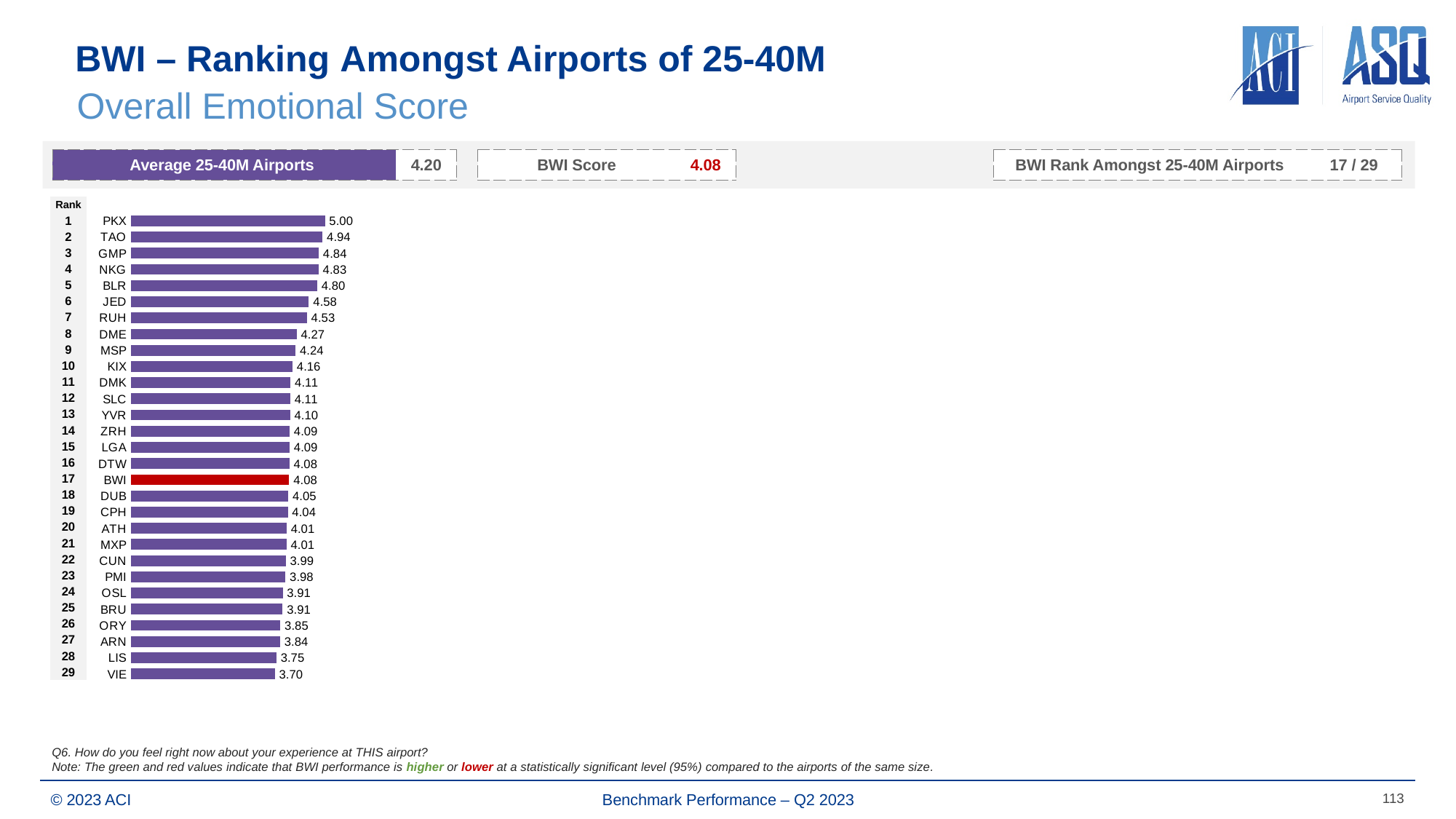
Which airport has the highest Overall Emotional Score? PKX What is the difference between the scores of PKX and VIE? 1.30 How many airports are ranked in the chart? 29 What is the score shown for PKX? 5.00 What is BWI's rank amongst 25-40M airports? 17 / 29 What is the Overall Emotional Score for BWI? 4.08 What is the score shown for VIE? 3.70 What kind of chart is shown on the slide? Bar chart What is the difference between the Average 25-40M Airports score and the BWI Score? 0.12 Which has a higher score, JED or DME? JED What colour is the bar for BWI? Red Which airport has the lowest Overall Emotional Score? VIE